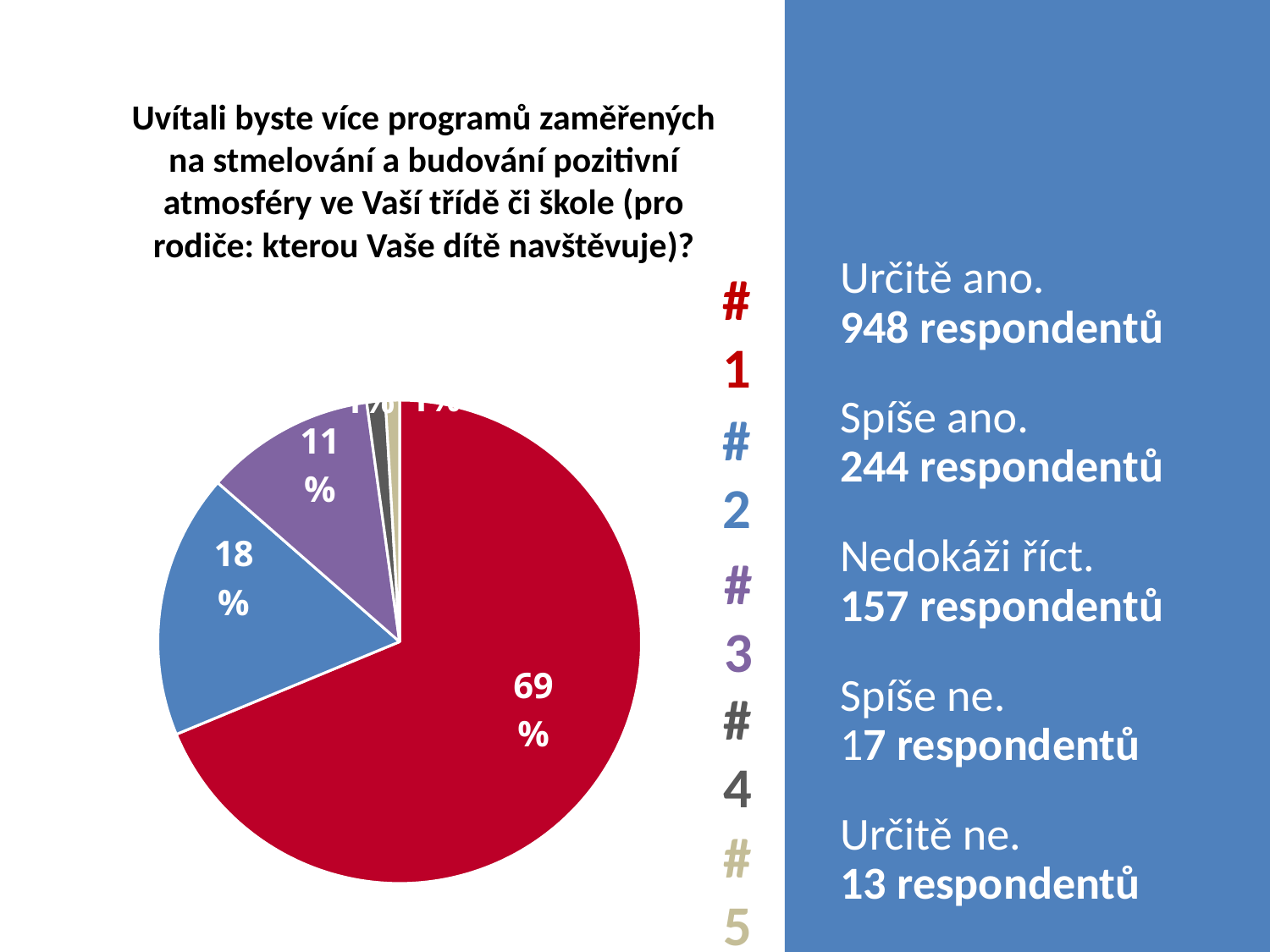
What is the difference in percentage points between slice #2 and slice #3? 7% Which slice is larger, #1 or #4? #1 What percentage of the pie does slice #1 represent? 69% Which slice is the largest in the pie chart? #1 What percentage of the pie does slice #3 represent? 11% What is the difference in percentage points between slice #1 and slice #2? 51% What kind of chart is shown on the slide? pie chart How many entries does the legend of the pie chart list? 5 Which slice is larger, #2 or #3? #2 Is the share of slice #1 greater or less than 50%? greater What colour is the largest slice of the pie chart? red What percentage of the pie does slice #2 represent? 18%